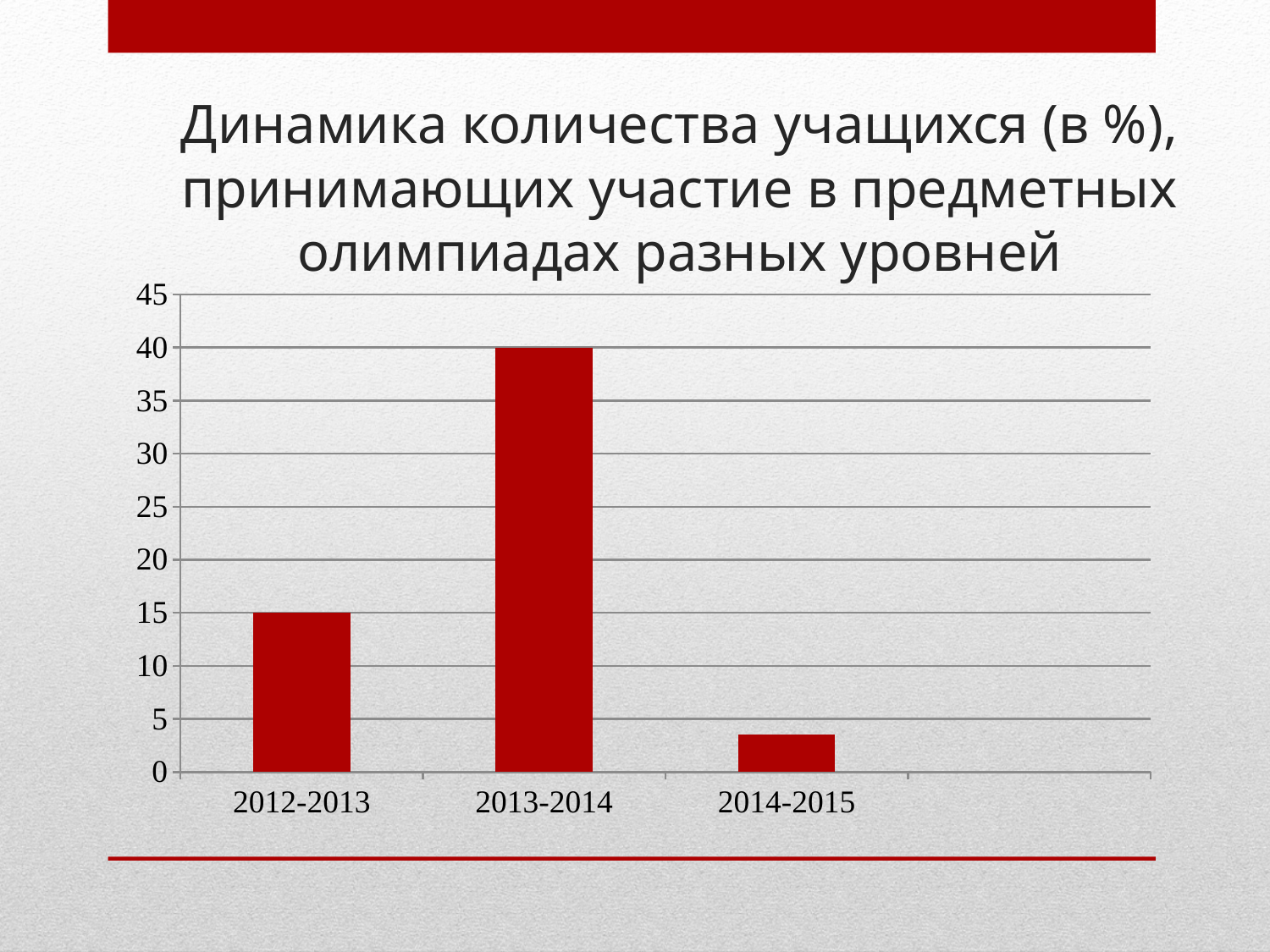
What is the value for 2013-2014? 40 What is the maximum value shown on the vertical axis? 45 How many categories (school years) are shown on the x axis? 3 Is the value for 2014-2015 greater or less than 5? less What kind of chart is shown on the slide? bar chart Is the value for 2013-2014 greater or less than 35? greater Does the value rise or fall from 2013-2014 to 2014-2015? fall Which school year has the highest value? 2013-2014 Which school year has the lowest value? 2014-2015 What is the value for 2012-2013? 15 What is the difference between the values for 2013-2014 and 2012-2013? 25 Which is larger, the value for 2012-2013 or the value for 2014-2015? 2012-2013